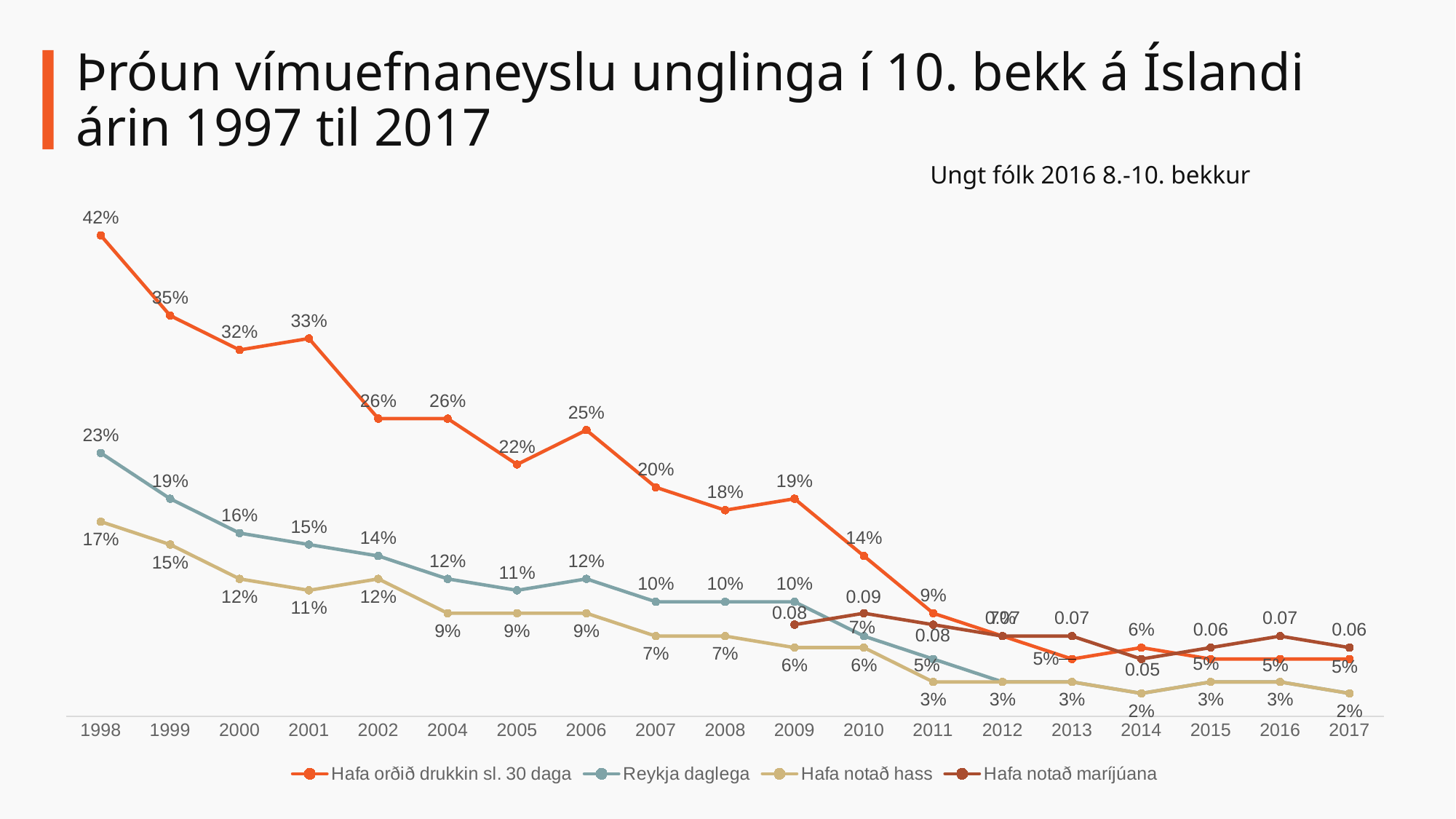
Does the "Hafa orðið drukkin sl. 30 daga" series generally rise or fall from 1998 to 2017? Fall In which year is the "Hafa orðið drukkin sl. 30 daga" series at its highest? 1998 In which year is the "Hafa notað maríjúana" series at its lowest? 2014 What is the value for "Reykja daglega" in 2000? 16% What is the value for "Hafa notað maríjúana" in 2010? 0.09 What kind of chart is shown on the slide? Line chart How many years are shown on the x axis? 19 In 2006, which is larger: "Hafa orðið drukkin sl. 30 daga" or "Reykja daglega"? Hafa orðið drukkin sl. 30 daga What is the value for "Hafa orðið drukkin sl. 30 daga" in 1998? 42% How many series does the legend list? 4 What is the value for "Hafa notað hass" in 2017? 2% By how many percentage points did "Hafa orðið drukkin sl. 30 daga" fall from 1998 to 2017? 37 percentage points